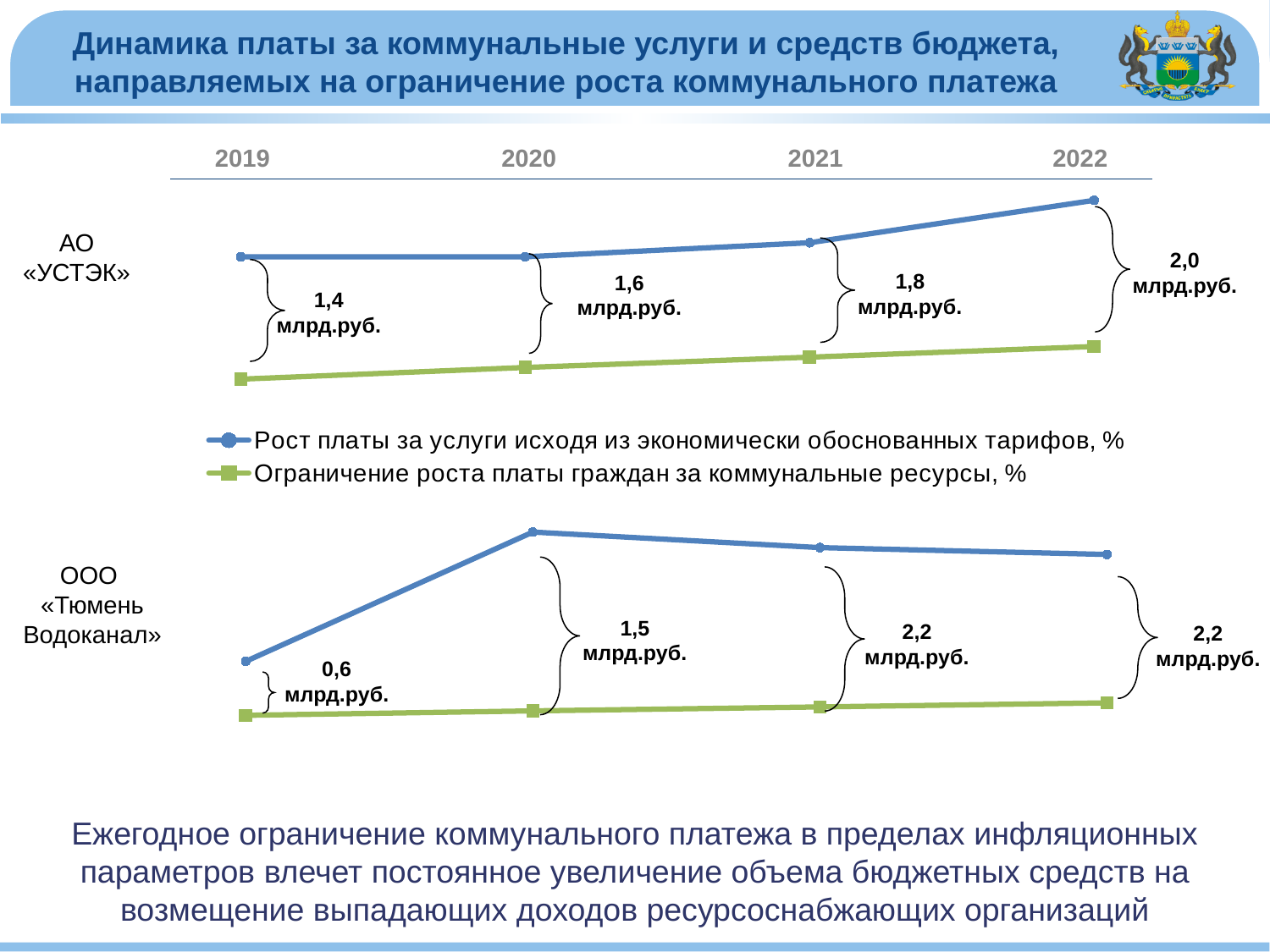
In the ООО «Тюмень Водоканал» chart, what budget amount is labelled for 2019? 0,6 млрд.руб. In the AO «УСТЭК» chart, what budget amount is labelled for 2019? 1,4 млрд.руб. In the AO «УСТЭК» chart, what budget amount is labelled for 2022? 2,0 млрд.руб. In the ООО «Тюмень Водоканал» chart, which year has the smallest labelled budget amount? 2019 In the AO «УСТЭК» chart, which year has the largest labelled budget amount? 2022 How many series does the legend list? 2 How many years are shown on the x axis of the charts? 4 Which is larger: the 2020 labelled amount in the AO «УСТЭК» chart or the 2020 labelled amount in the ООО «Тюмень Водоканал» chart? AO «УСТЭК» (1,6 млрд.руб.) In the AO «УСТЭК» chart, what is the difference between the labelled amounts for 2022 and 2019? 0,6 млрд.руб. In the ООО «Тюмень Водоканал» chart, what budget amount is labelled for 2021? 2,2 млрд.руб. In the ООО «Тюмень Водоканал» chart, what is the difference between the labelled amounts for 2022 and 2019? 1,6 млрд.руб. What type of chart is used for AO «УСТЭК»? Line chart